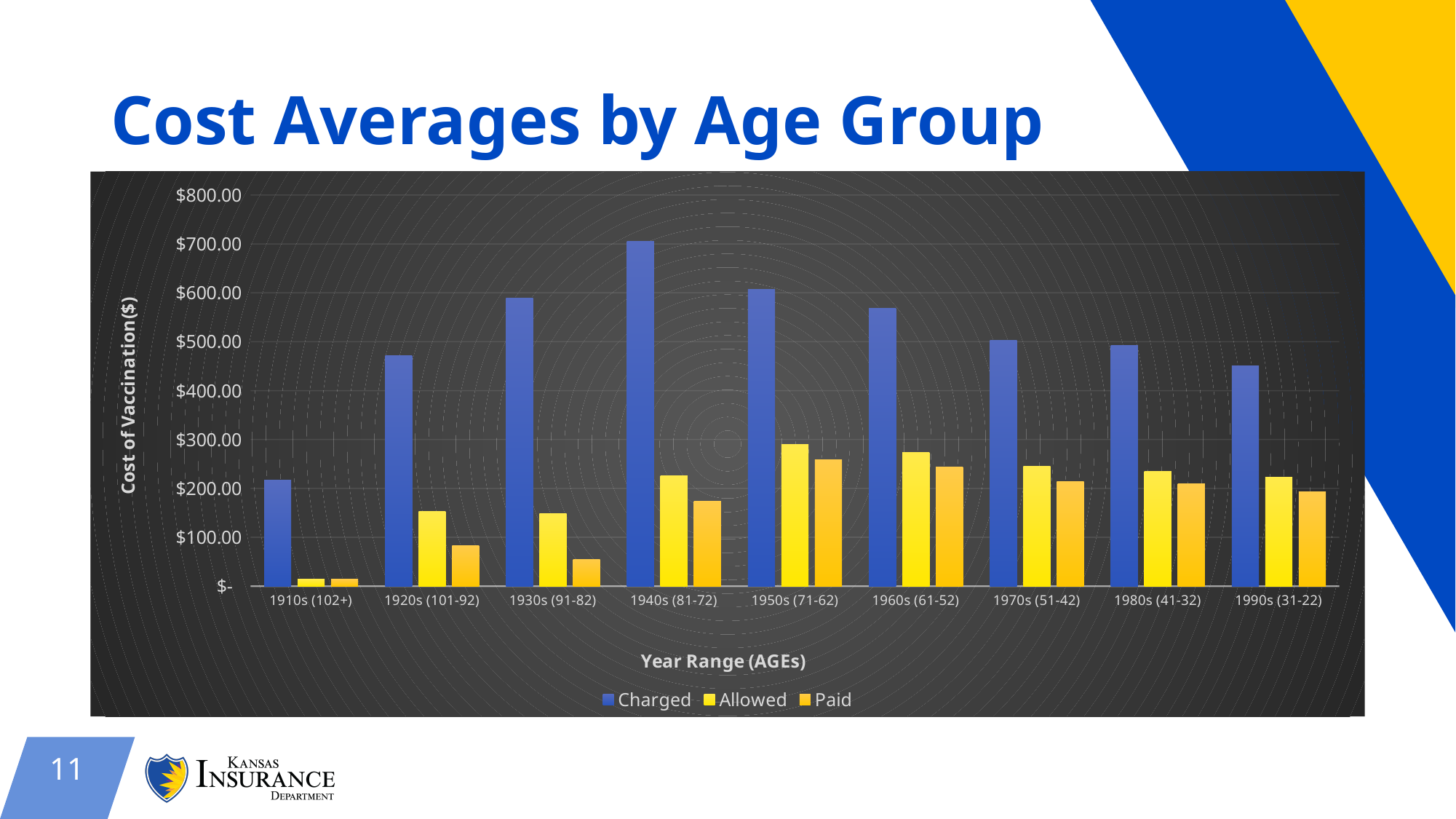
What kind of chart is shown on the slide? bar chart Which age group has the highest Charged value? 1940s (81-72) Which is larger, the Charged value for 1950s (71-62) or for 1970s (51-42)? 1950s (71-62) Is the Charged value for 1940s (81-72) greater or less than $600.00? greater Do the Charged values rise or fall from 1940s (81-72) to 1990s (31-22)? fall How many series does the legend list? 3 Is the Paid value for 1930s (91-82) greater or less than $100.00? less Which age group has the lowest Charged value? 1910s (102+) What is the label of the y axis? Cost of Vaccination($) Which age group has the highest Allowed value? 1950s (71-62) How many age-group categories are shown on the x axis? 9 Is the Charged value for 1910s (102+) greater or less than $300.00? less